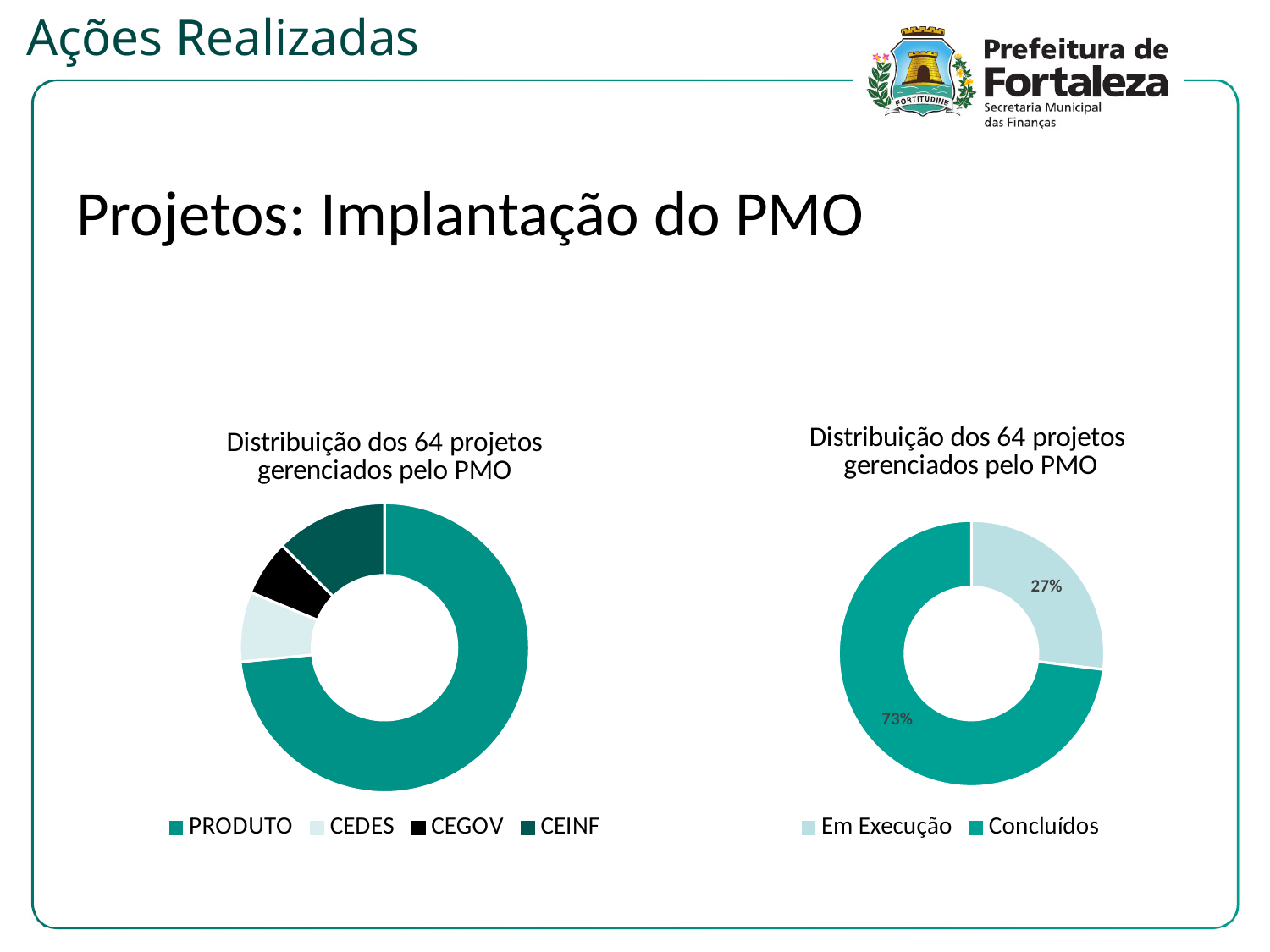
What is the title of the right chart? Distribuição dos 64 projetos gerenciados pelo PMO In the left chart, which category is shown in black? CEGOV What kind of chart is the left chart? Doughnut chart In the right chart, which category has the smaller share? Em Execução In the left chart, which is larger, PRODUTO or CEINF? PRODUTO In the right chart, what percentage of projects are 'Em Execução'? 27% In the right chart, which category has the larger share? Concluídos How many categories does the legend of the left chart list? 4 In the left chart, which category has the largest share? PRODUTO In the right chart, what percentage of projects are 'Concluídos'? 73% How many categories does the legend of the right chart list? 2 In the right chart, what is the difference in percentage points between 'Concluídos' and 'Em Execução'? 46 percentage points